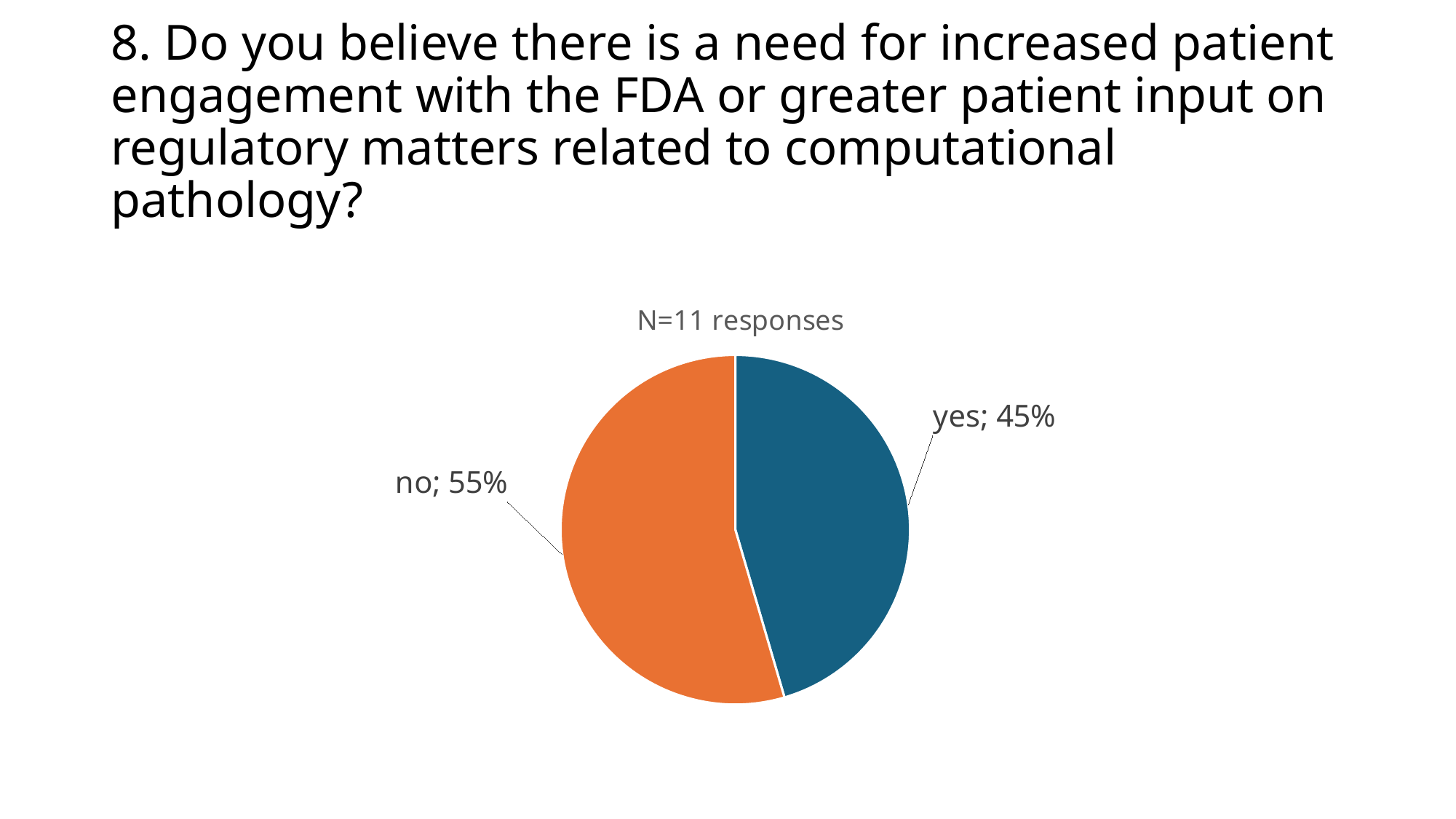
How many slices does the pie chart have? 2 What percentage of responses were "no"? 55% Which response has the larger share of the pie? no How many responses does the chart say it is based on? 11 Is the share for "yes" larger or smaller than the share for "no"? smaller What is the difference in percentage points between the "no" and "yes" shares? 10 Is the share for "no" greater or less than 50%? greater What percentage of responses were "yes"? 45% What colour is the "no" slice of the pie? orange What kind of chart is shown on the slide? pie chart Which response has the smaller share of the pie? yes